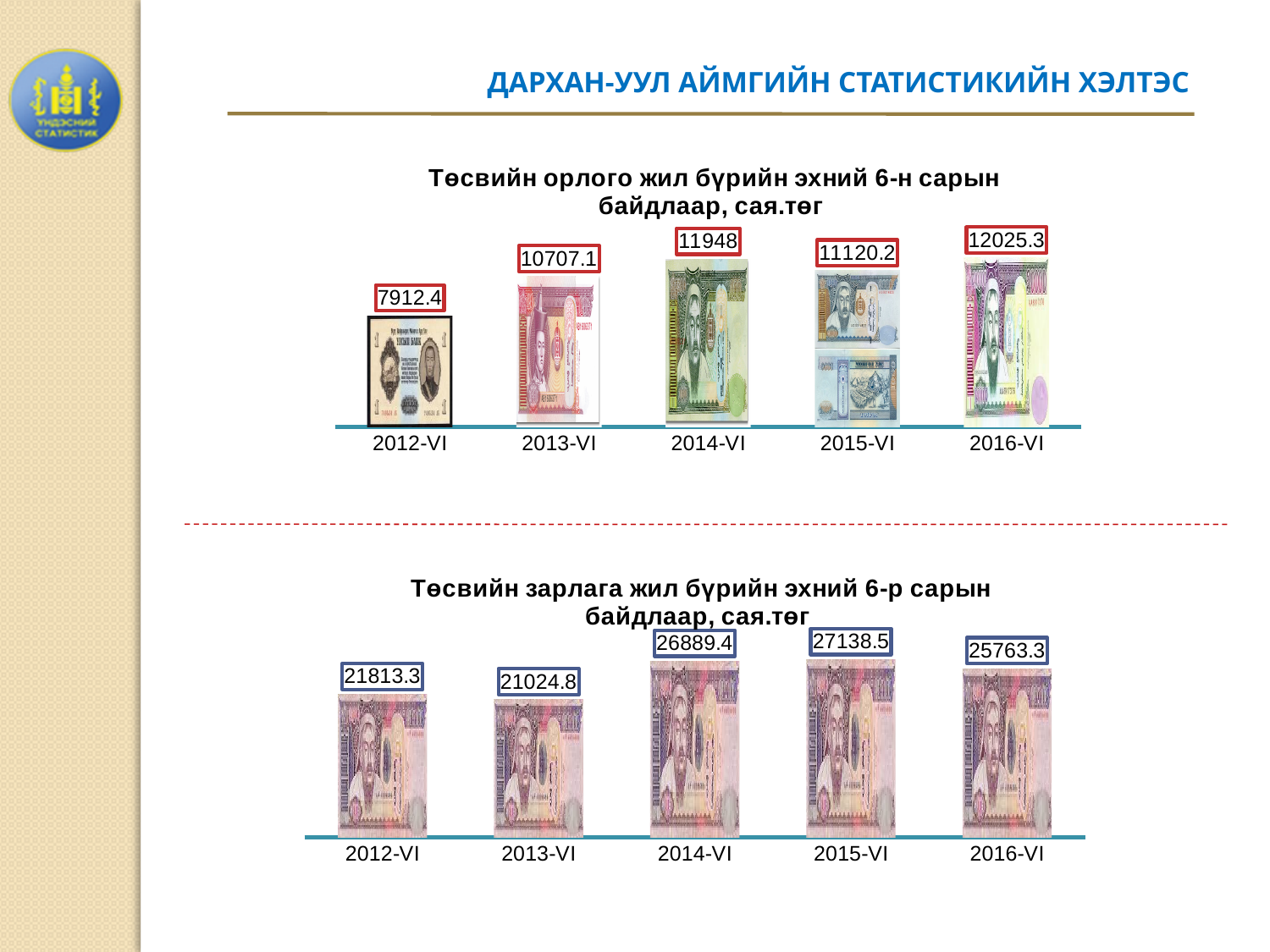
In the bottom chart (Төсвийн зарлага), what is the value for 2015-VI? 27138.5 In the bottom chart (Төсвийн зарлага), what is the difference between the values for 2014-VI and 2016-VI? 1126.1 In the top chart (Төсвийн орлого), how many years are shown on the x axis? 5 What kind of chart is the top chart (Төсвийн орлого)? Bar chart In the bottom chart (Төсвийн зарлага), which is larger, the value for 2012-VI or 2013-VI? 2012-VI In the bottom chart (Төсвийн зарлага), what is the value for 2013-VI? 21024.8 In the top chart (Төсвийн орлого), which year has the highest value? 2016-VI In the top chart (Төсвийн орлого), what is the difference between the values for 2014-VI and 2015-VI? 827.8 In the top chart (Төсвийн орлого), what is the value for 2016-VI? 12025.3 In the top chart (Төсвийн орлого), which year has the lowest value? 2012-VI In the top chart (Төсвийн орлого), what is the value for 2012-VI? 7912.4 In the bottom chart (Төсвийн зарлага), which year has the highest value? 2015-VI